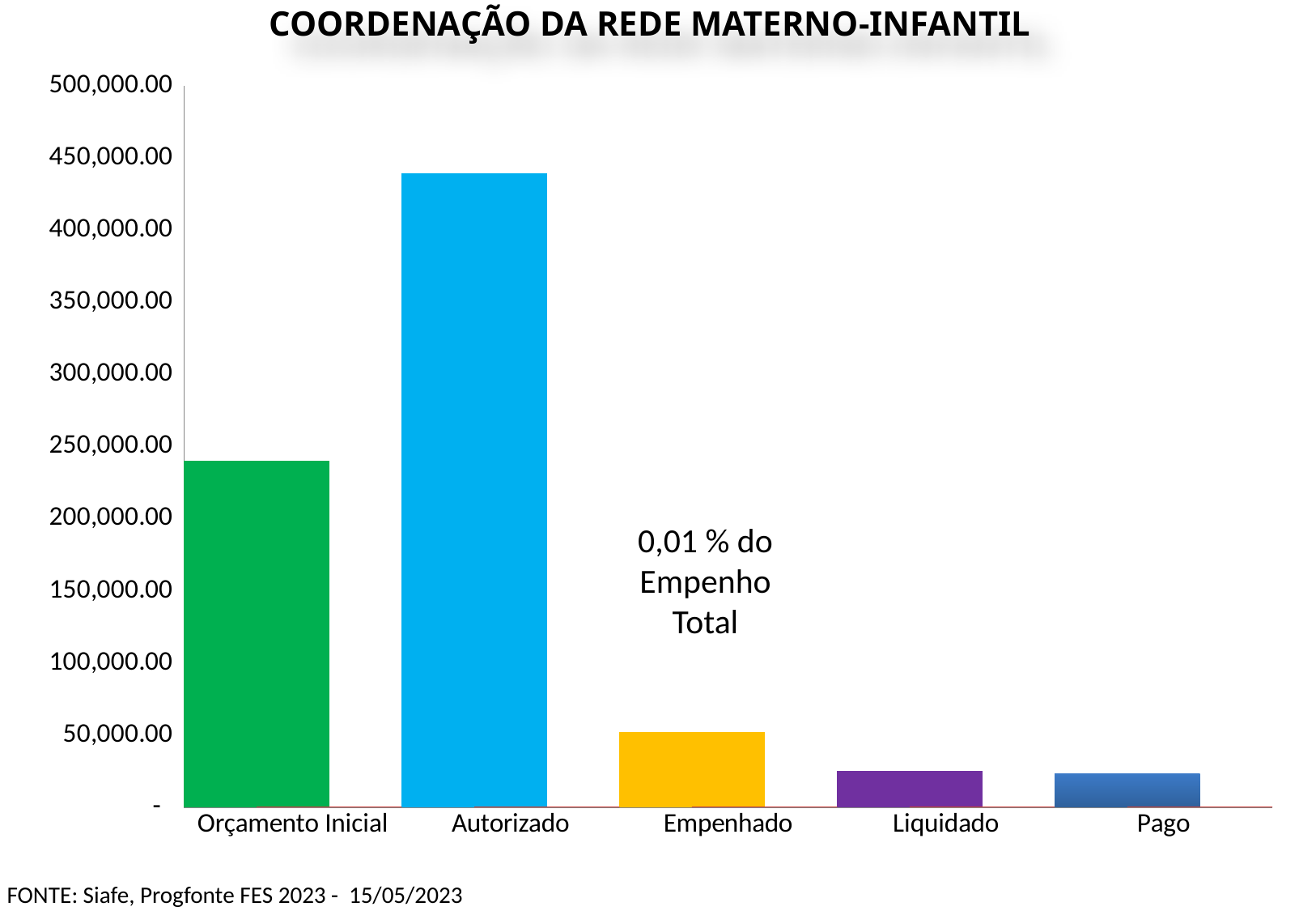
Is the value for Orçamento Inicial greater or less than 200,000.00? greater Is the value for Empenhado greater or less than 100,000.00? less Which category has the highest value in the chart? Autorizado What is the title of the chart? COORDENAÇÃO DA REDE MATERNO-INFANTIL Is the value for Autorizado greater or less than 400,000.00? greater What kind of chart is shown on the slide? bar chart Which is larger, the value for Empenhado or the value for Liquidado? Empenhado Do the values rise or fall along the x axis from Autorizado to Pago? fall How many categories are shown on the x axis of the chart? 5 What text annotation is printed above the Empenhado bar? 0,01 % do Empenho Total Which is larger, the value for Orçamento Inicial or the value for Autorizado? Autorizado